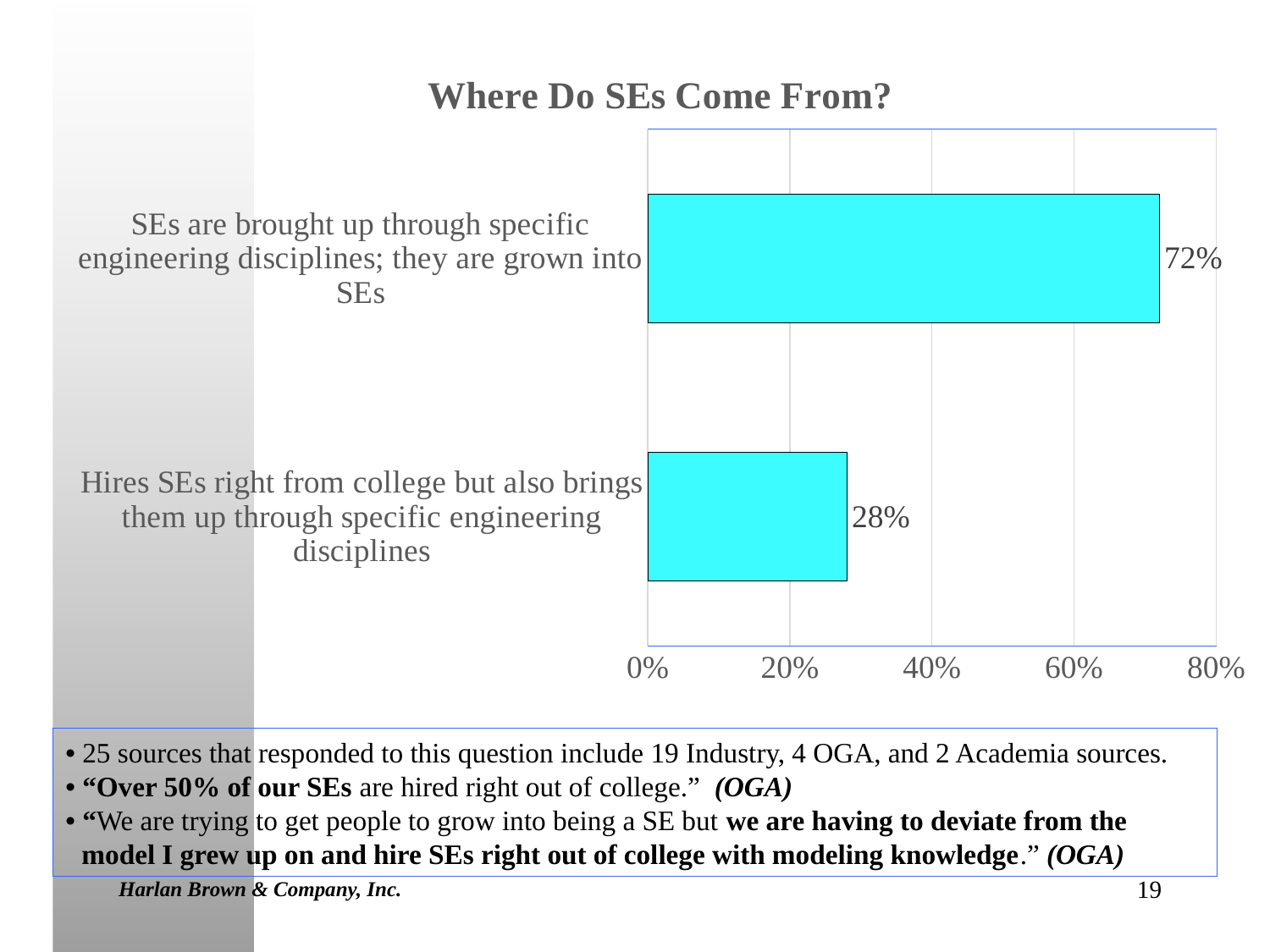
Is the value for "SEs are brought up through specific engineering disciplines; they are grown into SEs" greater or less than 60%? greater Is the value for "Hires SEs right from college but also brings them up through specific engineering disciplines" greater or less than 40%? less Which is larger: the value for SEs grown into SEs through specific engineering disciplines, or the value for hiring SEs right from college? SEs are brought up through specific engineering disciplines; they are grown into SEs What is the title of the chart? Where Do SEs Come From? What is the difference between the two bars' values? 44% What kind of chart is shown on the slide? Bar chart What is the value for "SEs are brought up through specific engineering disciplines; they are grown into SEs"? 72% How many categories are shown in the chart? 2 Which category has the highest value? SEs are brought up through specific engineering disciplines; they are grown into SEs Which category has the lowest value? Hires SEs right from college but also brings them up through specific engineering disciplines What is the maximum value shown on the x axis? 80% What is the value for "Hires SEs right from college but also brings them up through specific engineering disciplines"? 28%